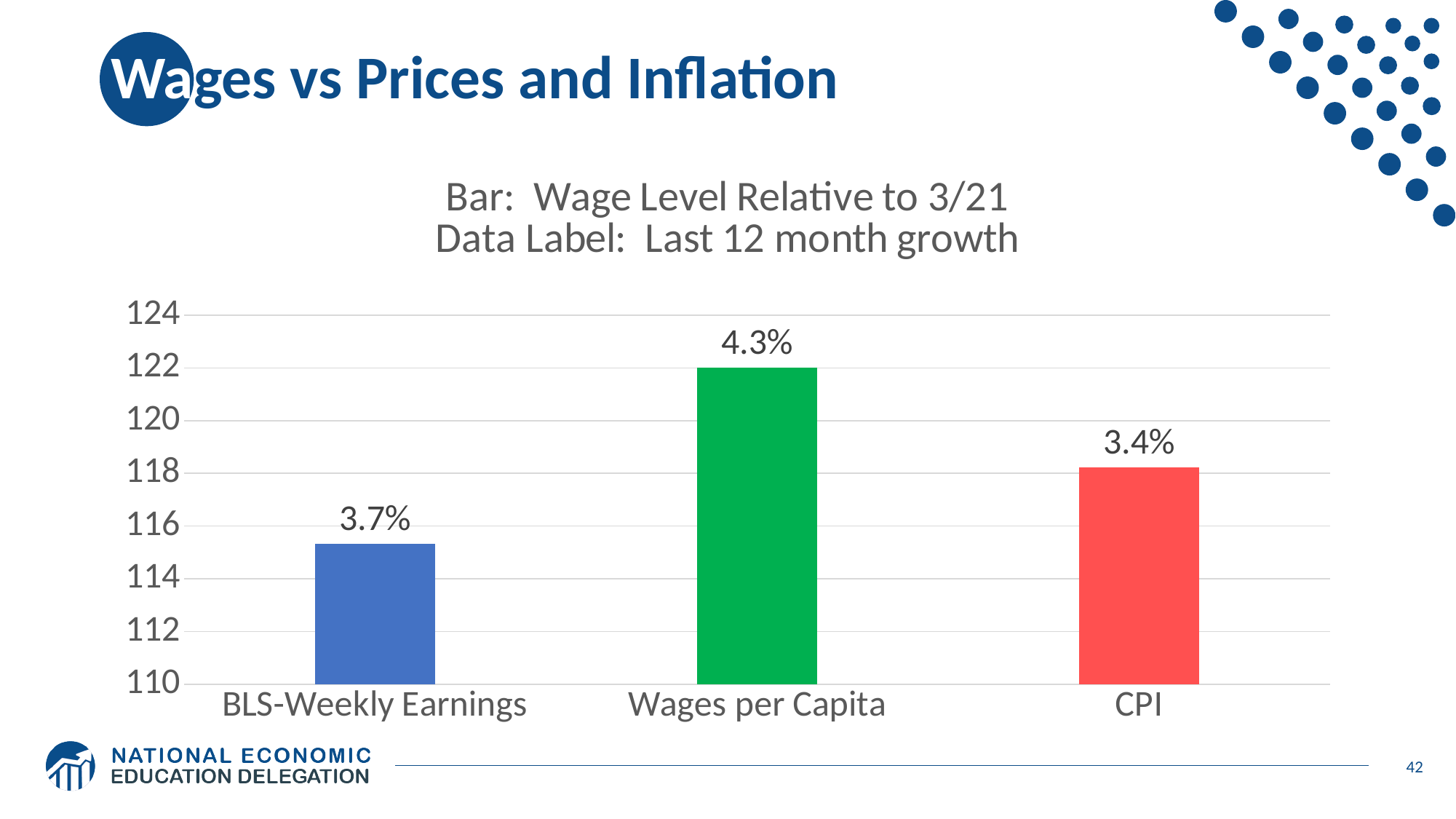
Is the bar height (wage level relative to 3/21) for CPI greater or less than 118? greater Which category has the lowest last 12 month growth data label? CPI What is the data label (last 12 month growth) shown for Wages per Capita? 4.3% Which bar is taller, CPI or BLS-Weekly Earnings? CPI How many categories are shown on the chart? 3 What is the data label (last 12 month growth) shown for BLS-Weekly Earnings? 3.7% What is the difference between the growth data labels for Wages per Capita and CPI? 0.9% Is the bar height (wage level relative to 3/21) for BLS-Weekly Earnings greater or less than 116? less What is the data label (last 12 month growth) shown for CPI? 3.4% Which category has the highest last 12 month growth data label? Wages per Capita What type of chart is shown on the slide? Bar chart What is the difference between the growth data labels for Wages per Capita and BLS-Weekly Earnings? 0.6%